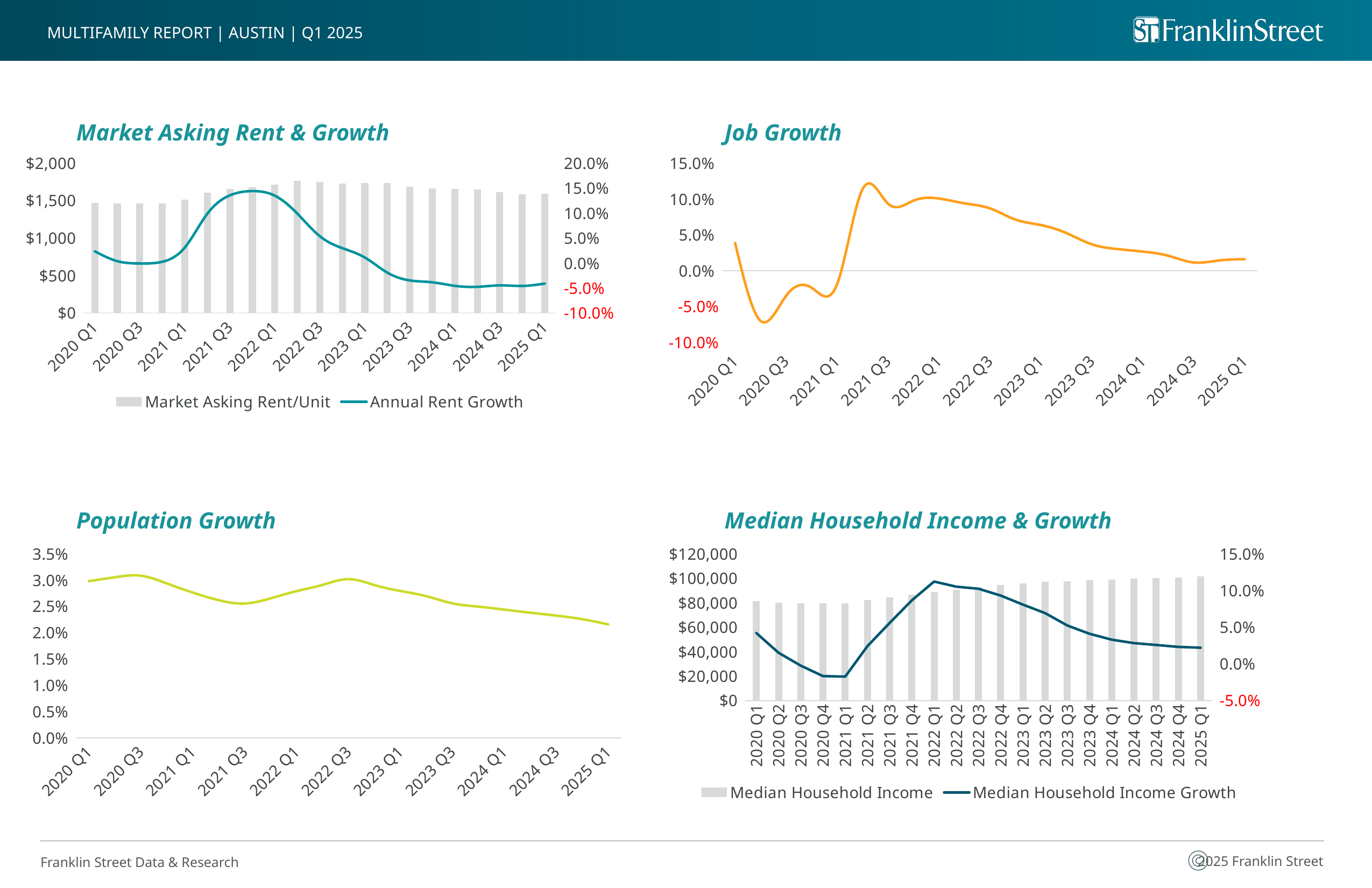
In the Population Growth chart, is the value for 2025 Q1 greater or less than 2.0%? greater In the Job Growth chart, is the value for 2025 Q1 greater or less than 0.0%? greater In the Job Growth chart, which quarter has the lowest job growth? 2020 Q2 In the Population Growth chart, do values generally rise or fall from 2022 Q3 to 2025 Q1? fall In the Job Growth chart, is the value for 2020 Q3 greater or less than -5.0%? greater In the Median Household Income & Growth chart, which quarter has the highest Median Household Income Growth? 2022 Q1 How many series does the legend of the Market Asking Rent & Growth chart list? 2 What kind of chart is the Job Growth chart? line chart